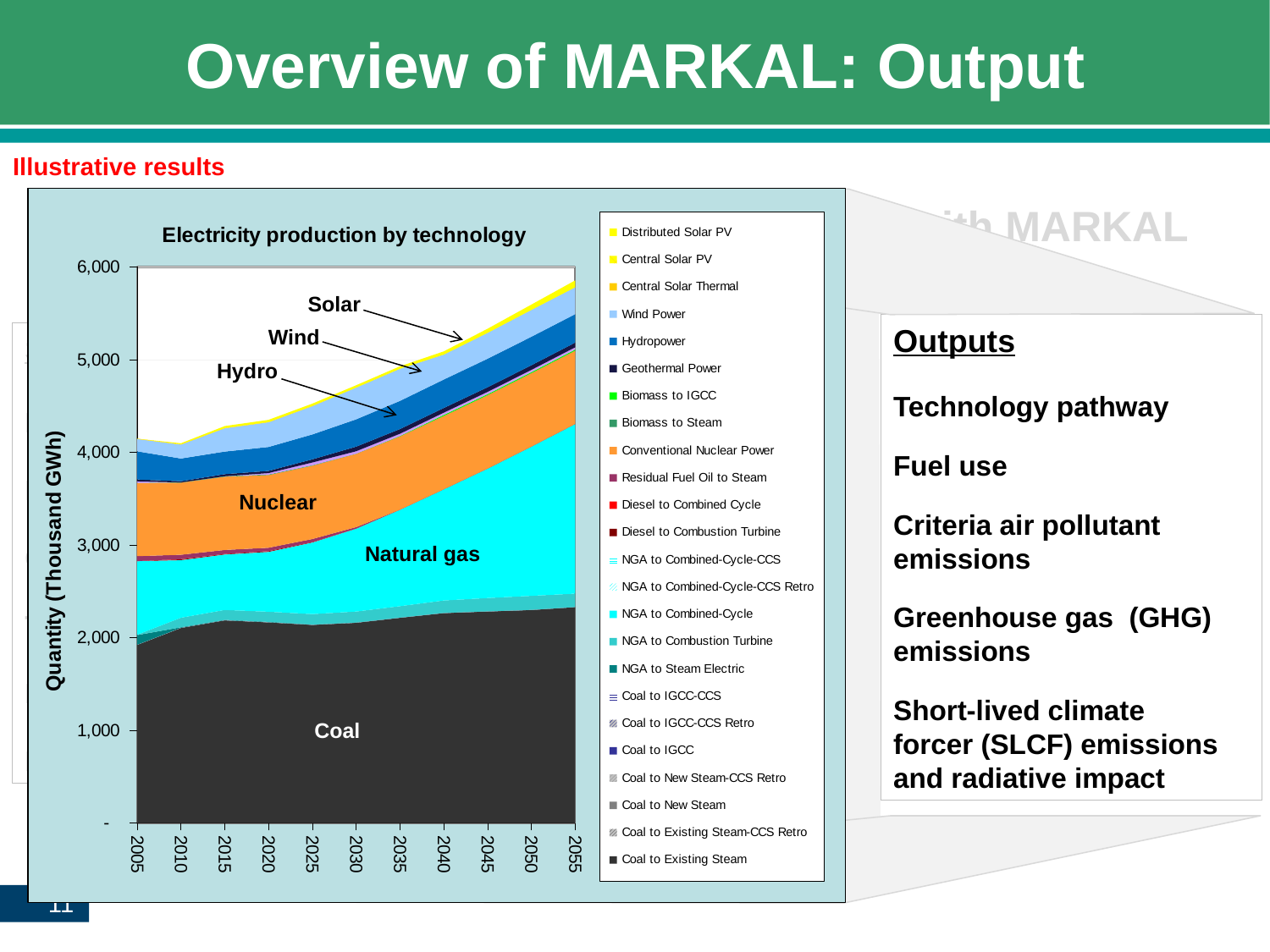
Is the total electricity production in 2055 greater or less than 5,000 thousand GWh? greater How many years are labelled along the x axis of the chart? 11 What kind of chart is shown on the slide? Stacked area chart Is the total electricity production in 2005 greater or less than 5,000 thousand GWh? less Is the coal area in 2055 greater or less than 2,000 thousand GWh? greater How many entries does the chart's legend list? 24 Does total electricity production rise or fall from 2005 to 2055 in the chart? Rise Which is larger in 2055, the Coal area or the Natural gas area? Coal What is the label of the y axis of the chart? Quantity (Thousand GWh) What is the title of the chart on the slide? Electricity production by technology